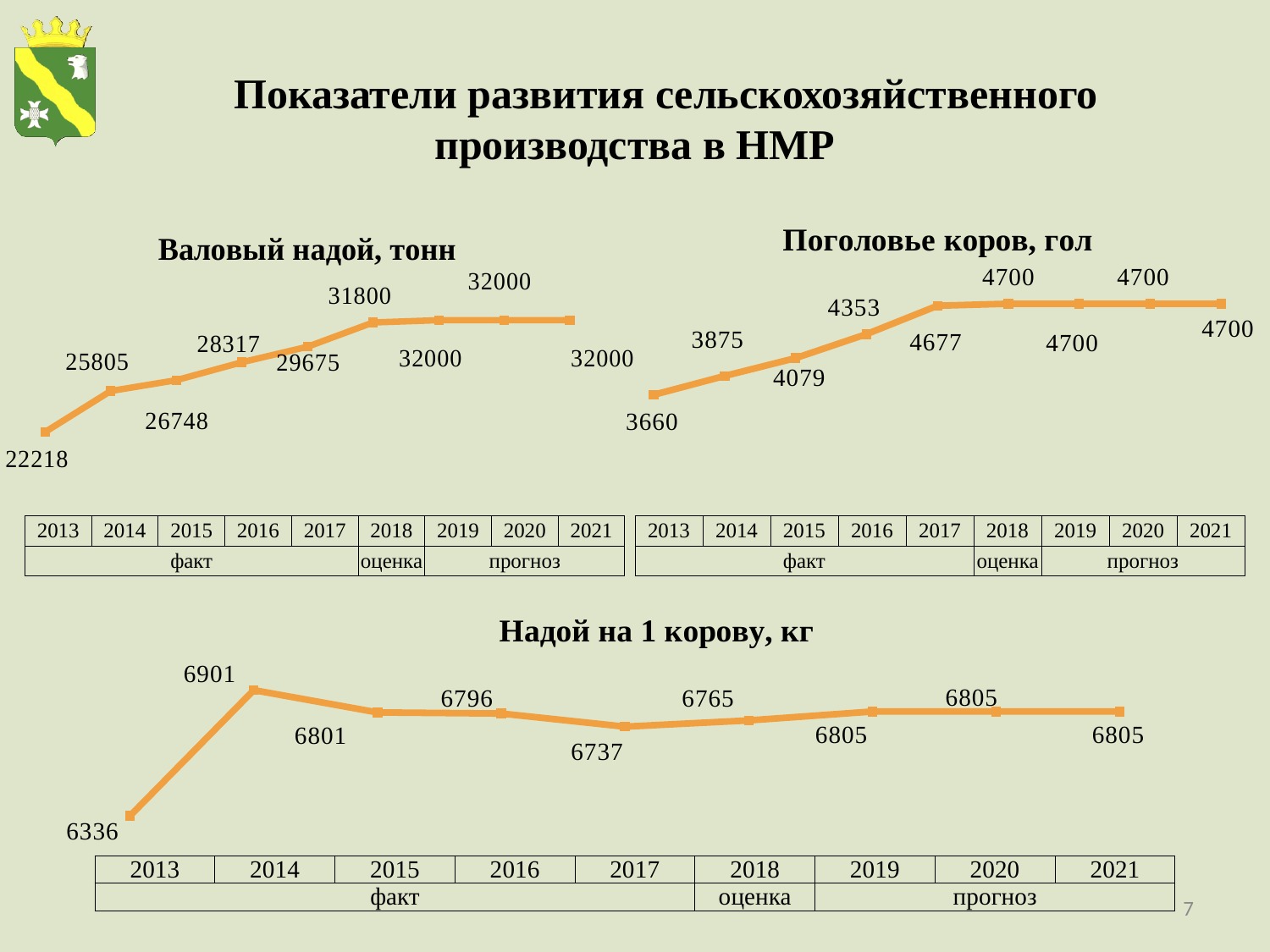
In the chart 'Надой на 1 корову, кг', which year has the highest value? 2014 In the chart 'Поголовье коров, гол', do the values rise or fall from 2013 to 2017? rise In the chart 'Поголовье коров, гол', what is the difference between the 2017 and 2013 values? 1017 In the chart 'Валовый надой, тонн', what is the value for 2018? 31800 What type of chart is 'Поголовье коров, гол'? line chart In the chart 'Валовый надой, тонн', what is the value for 2013? 22218 How many years are plotted in the chart 'Надой на 1 корову, кг'? 9 In the chart 'Надой на 1 корову, кг', what is the value for 2017? 6737 In the chart 'Валовый надой, тонн', which year has the lowest value? 2013 In the chart 'Поголовье коров, гол', what is the value for 2016? 4353 In the chart 'Валовый надой, тонн', what is the difference between the 2017 and 2016 values? 1358 In the chart 'Надой на 1 корову, кг', which is larger, the value for 2015 or the value for 2018? 2015